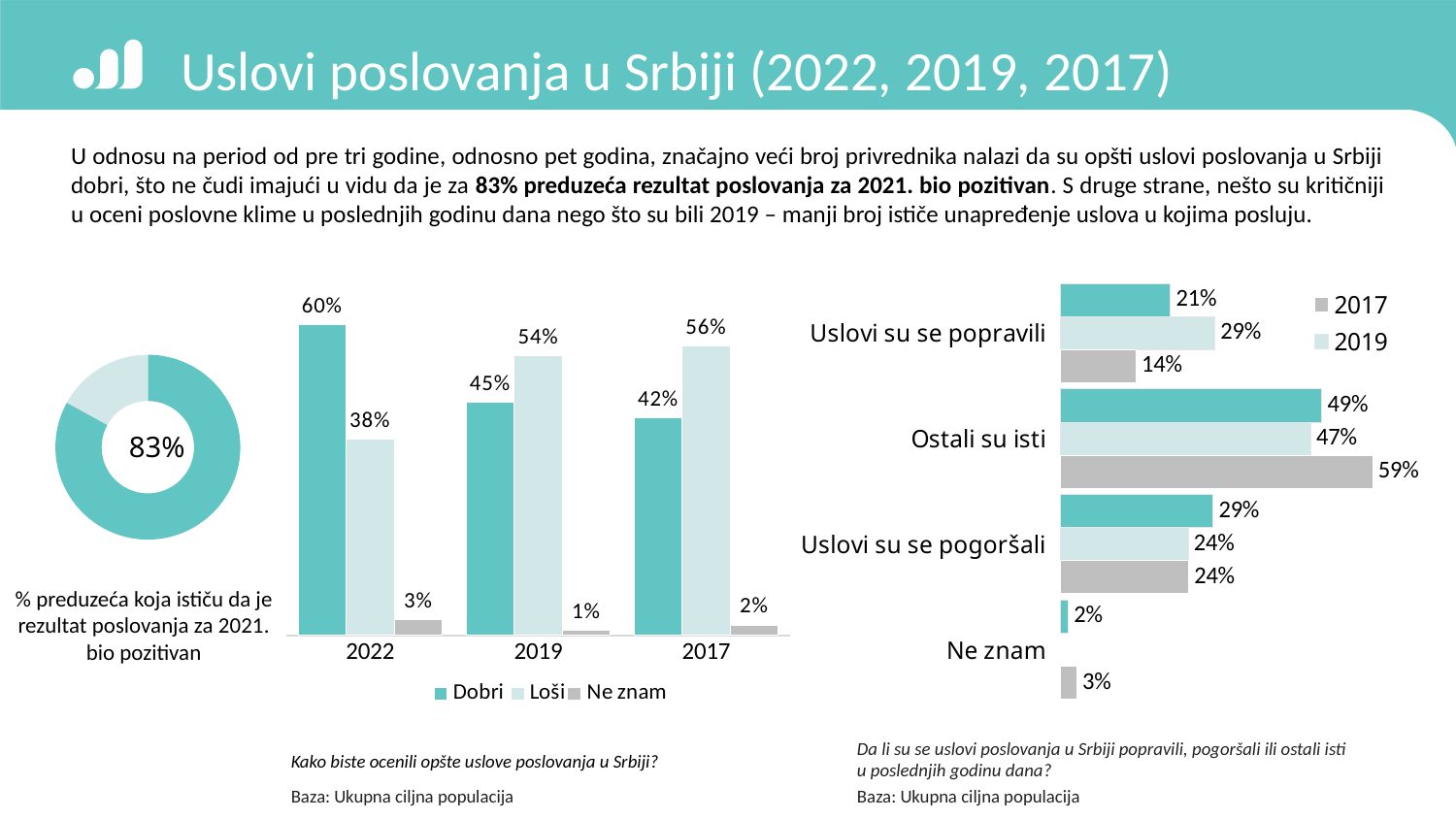
In the right-hand bar chart, which is larger for 2019: 'Uslovi su se popravili' or 'Uslovi su se pogoršali'? Uslovi su se popravili What value is shown in the centre of the donut chart on the left? 83% In the right-hand bar chart, what is the 2019 value for 'Uslovi su se popravili'? 29% In the middle bar chart, does the 'Dobri' value rise or fall from 2022 to 2017 along the x axis? fall In the middle bar chart, what percentage rated business conditions as 'Dobri' in 2022? 60% In the middle bar chart, what is the 'Ne znam' value for 2017? 2% What type of chart is the right-hand chart? bar chart In the middle bar chart, which year has the highest 'Dobri' value? 2022 In the middle bar chart, what is the 'Loši' value for 2019? 54% In the middle bar chart, what is the difference between the 'Dobri' and 'Loši' values for 2022? 22% In the right-hand bar chart, what is the 2017 value for 'Ostali su isti'? 59% In the middle bar chart, how many series does the legend list? 3